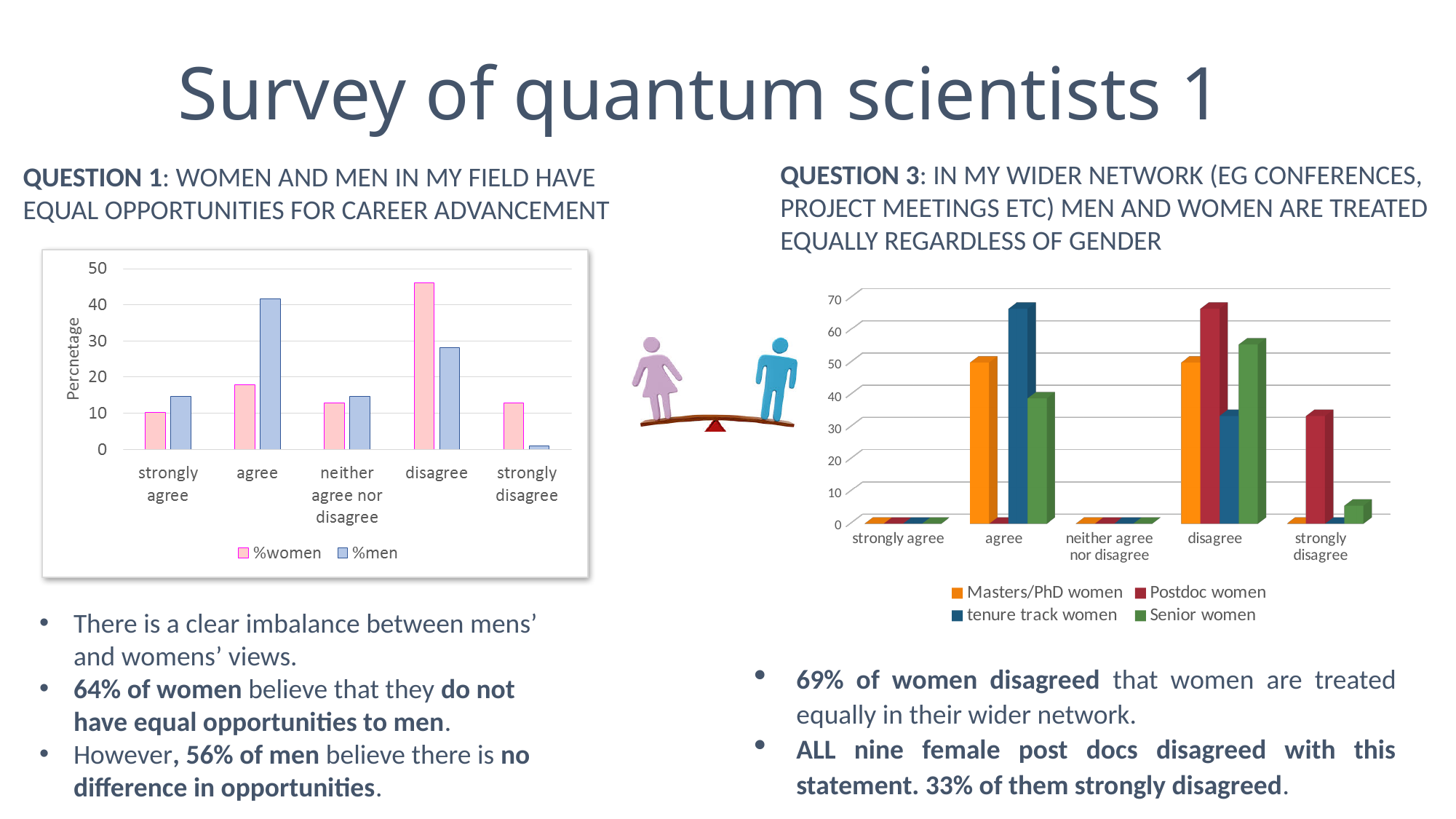
On the left chart (Question 1), is the %men value for agree greater or less than 40? greater On the right chart (Question 3), how many series does the legend list? 4 On the right chart (Question 3), which series has the highest value for disagree? Postdoc women On the right chart (Question 3), is the value for tenure track women at agree greater or less than 60? greater On the left chart (Question 1), which category has the lowest %men value? strongly disagree On the left chart (Question 1), which category has the highest %men value? agree On the left chart (Question 1), which category has the highest %women value? disagree On the left chart (Question 1), what kind of chart is shown? bar chart On the left chart (Question 1), what is the y-axis label? Percnetage On the left chart (Question 1), how many series does the legend list? 2 On the left chart (Question 1), how many response categories are shown on the x axis? 5 On the left chart (Question 1), for the disagree category, which is larger: %women or %men? %women